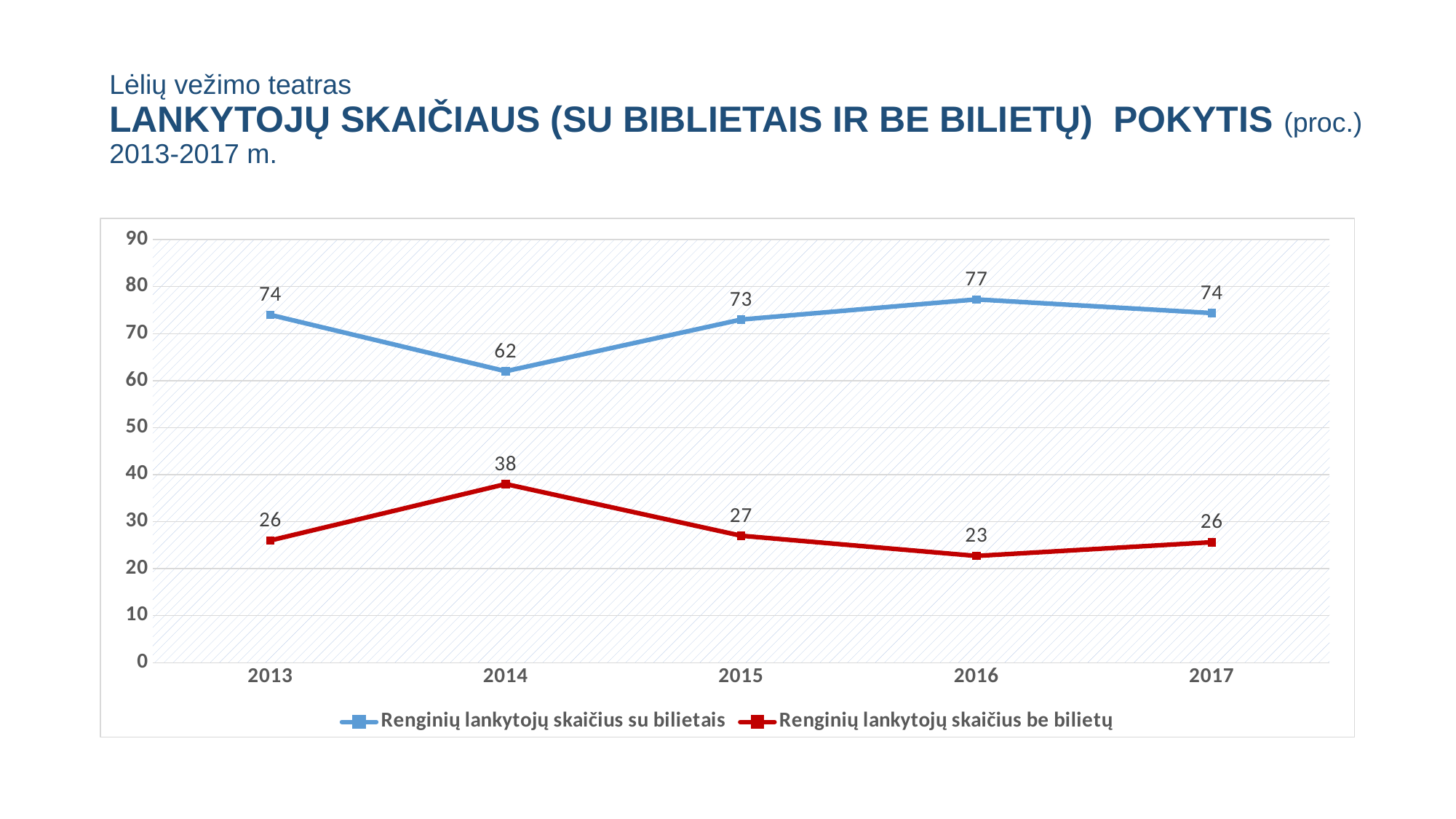
What is the value for "Renginių lankytojų skaičius be bilietų" in 2016? 23 In which year is "Renginių lankytojų skaičius su bilietais" highest? 2016 In which year is "Renginių lankytojų skaičius be bilietų" highest? 2014 How many series does the legend list? 2 Does "Renginių lankytojų skaičius su bilietais" rise or fall from 2014 to 2016? rise What colour is the line for "Renginių lankytojų skaičius be bilietų"? red In which year is "Renginių lankytojų skaičius be bilietų" lowest? 2016 What is the value for "Renginių lankytojų skaičius su bilietais" in 2014? 62 How many years are shown on the x axis? 5 What is the difference between the two series in 2014? 24 What kind of chart is shown on the slide? line chart Which is larger in 2015: "Renginių lankytojų skaičius su bilietais" or "Renginių lankytojų skaičius be bilietų"? Renginių lankytojų skaičius su bilietais